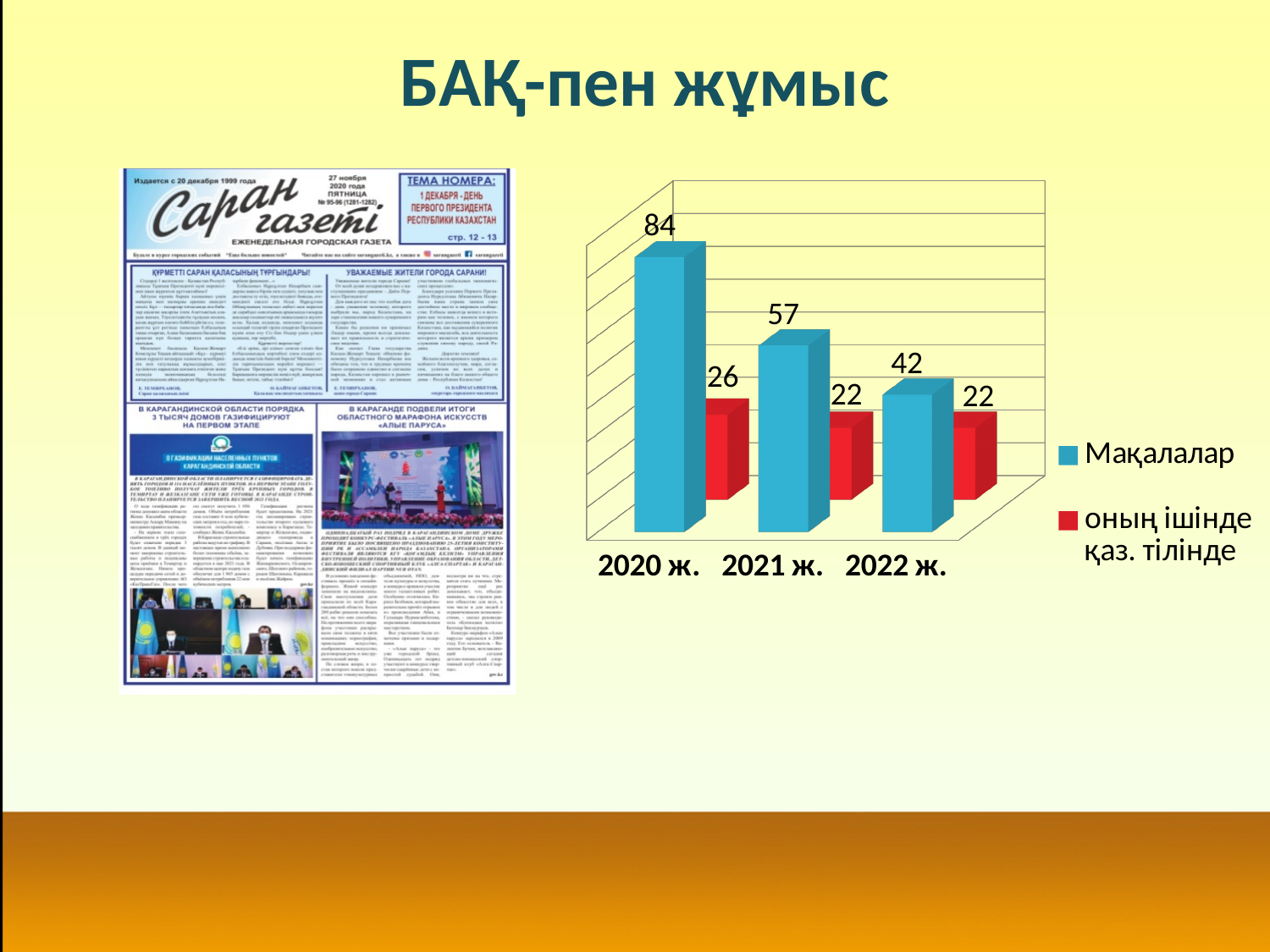
What kind of chart is shown on the slide? Bar chart What is the value of оның ішінде қаз. тілінде for 2021 ж.? 22 Which year has the lowest value for Мақалалар? 2022 ж. Do the Мақалалар values rise or fall from 2020 ж. to 2022 ж.? Fall How many years are shown on the x axis of the chart? 3 How many series does the chart legend list? 2 What is the value of Мақалалар for 2020 ж.? 84 Which is larger: Мақалалар for 2021 ж. or Мақалалар for 2022 ж.? Мақалалар for 2021 ж. What is the value of Мақалалар for 2022 ж.? 42 Which year has the highest value for Мақалалар? 2020 ж. What is the difference between Мақалалар and оның ішінде қаз. тілінде for 2022 ж.? 20 What is the difference between the Мақалалар values for 2020 ж. and 2021 ж.? 27